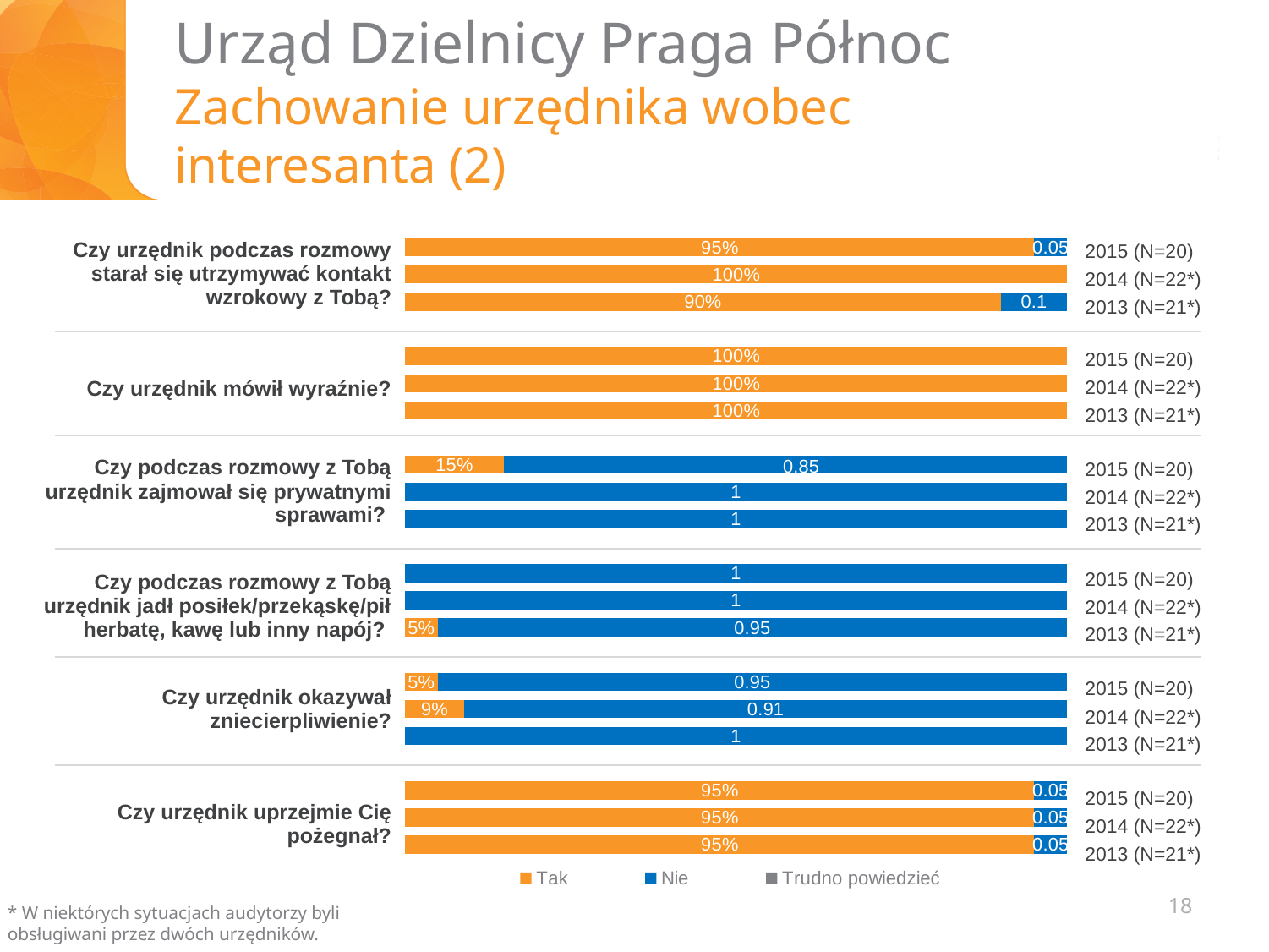
For "Czy urzędnik podczas rozmowy starał się utrzymywać kontakt wzrokowy z Tobą?", which year has the lowest "Tak" percentage? 2013 (N=21*) What percentage answered "Tak" in 2013 (N=21*) to "Czy podczas rozmowy z Tobą urzędnik jadł posiłek/przekąskę/pił herbatę, kawę lub inny napój?"? 5% Which legend entry is represented by the orange colour? Tak What percentage of respondents answered "Tak" in 2015 (N=20) to "Czy urzędnik podczas rozmowy starał się utrzymywać kontakt wzrokowy z Tobą?"? 95% What kind of chart is shown on the slide? Stacked bar chart What is the "Nie" value for 2014 (N=22*) for "Czy urzędnik okazywał zniecierpliwienie?"? 0.91 How many series does the legend list? 3 For "Czy urzędnik okazywał zniecierpliwienie?", which year has the higher "Tak" percentage, 2015 (N=20) or 2014 (N=22*)? 2014 (N=22*) How many survey questions are shown on the chart? 6 What is the "Nie" value shown for 2013 (N=21*) for "Czy urzędnik podczas rozmowy starał się utrzymywać kontakt wzrokowy z Tobą?"? 0.1 What "Tak" percentage is shown for all three years for "Czy urzędnik uprzejmie Cię pożegnał?"? 95% What percentage answered "Tak" in 2015 (N=20) to "Czy podczas rozmowy z Tobą urzędnik zajmował się prywatnymi sprawami?"? 15%